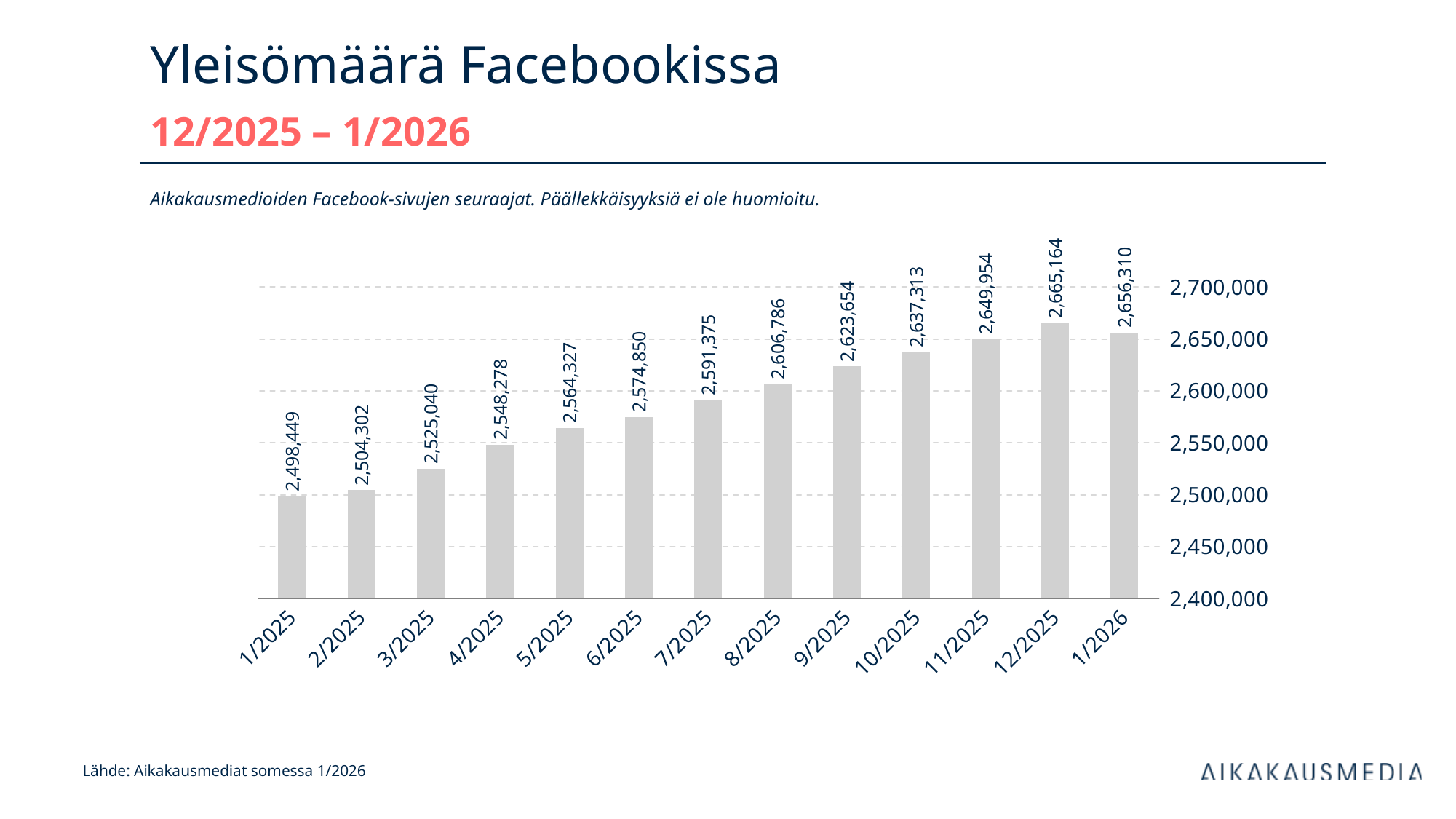
What is the difference between the values for 12/2025 and 1/2026? 8,854 How many months are shown on the x axis? 13 What is the value for 1/2025? 2,498,449 What is the title of the slide? Yleisömäärä Facebookissa What is the difference between the values for 1/2026 and 1/2025? 157,861 Which is larger, the value for 11/2025 or the value for 1/2026? 1/2026 Which month has the lowest value? 1/2025 What is the value for 7/2025? 2,591,375 Which month has the highest value? 12/2025 What is the value for 1/2026? 2,656,310 What kind of chart is shown on the slide? Bar chart What is the value for 12/2025? 2,665,164